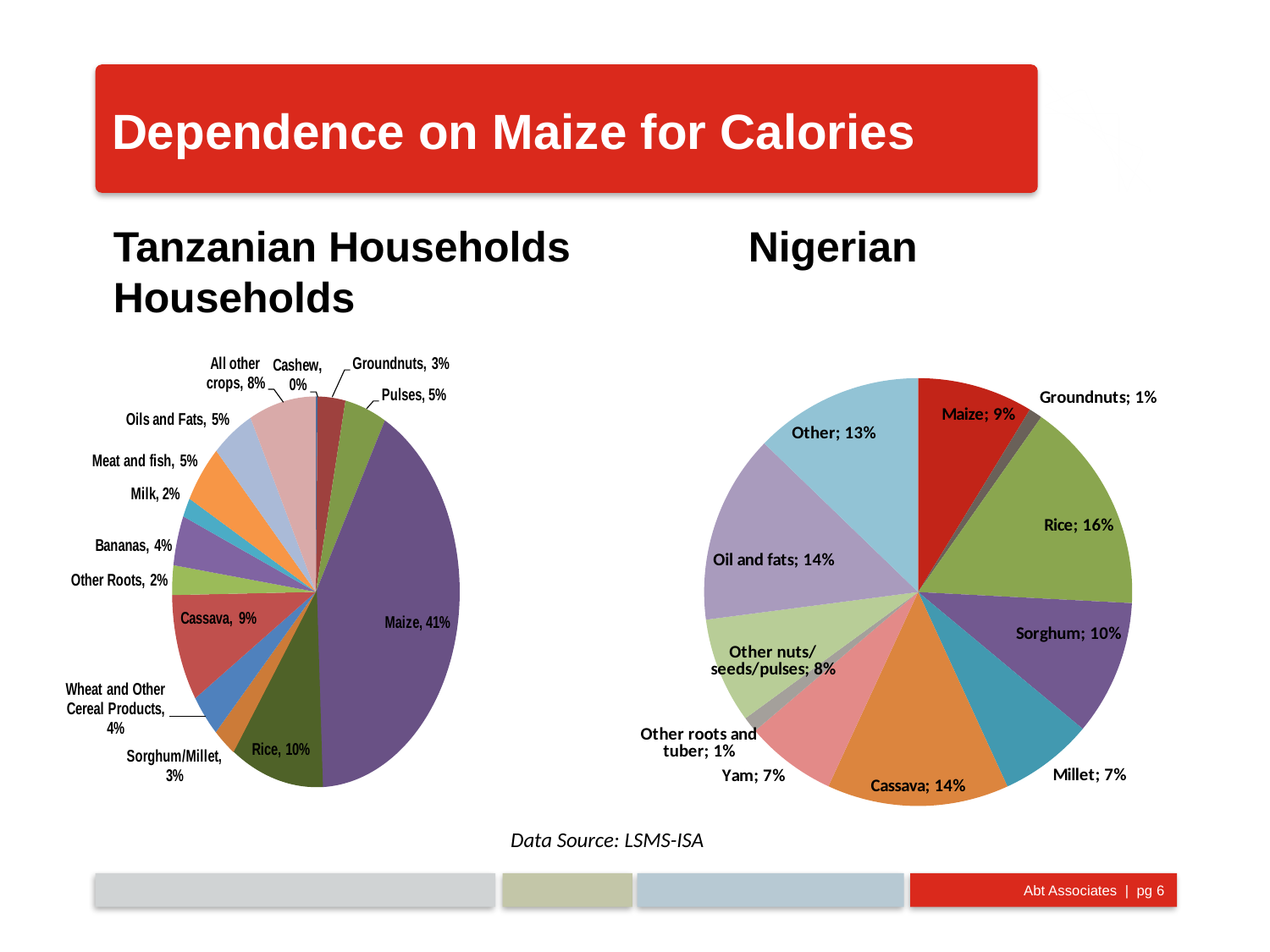
What is the title of the slide containing the two pie charts? Dependence on Maize for Calories In the Nigerian Households pie chart, what share of calories comes from Maize? 9% What is the difference between the Maize share in the Tanzanian Households chart and the Maize share in the Nigerian Households chart? 32 percentage points How many categories are shown in the Tanzanian Households pie chart? 14 In the Tanzanian Households pie chart, which category has the smallest share? Cashew How many categories are shown in the Nigerian Households pie chart? 11 In the Tanzanian Households pie chart, what is the share for Cassava? 9% In the Tanzanian Households pie chart, what share of calories comes from Maize? 41% In the Nigerian Households pie chart, what is the share for Oil and fats? 14% In the Nigerian Households pie chart, which category has the largest share? Rice In the Nigerian Households pie chart, which is larger: the share for Cassava or the share for Sorghum? Cassava What type of chart is used for the Tanzanian Households data? Pie chart